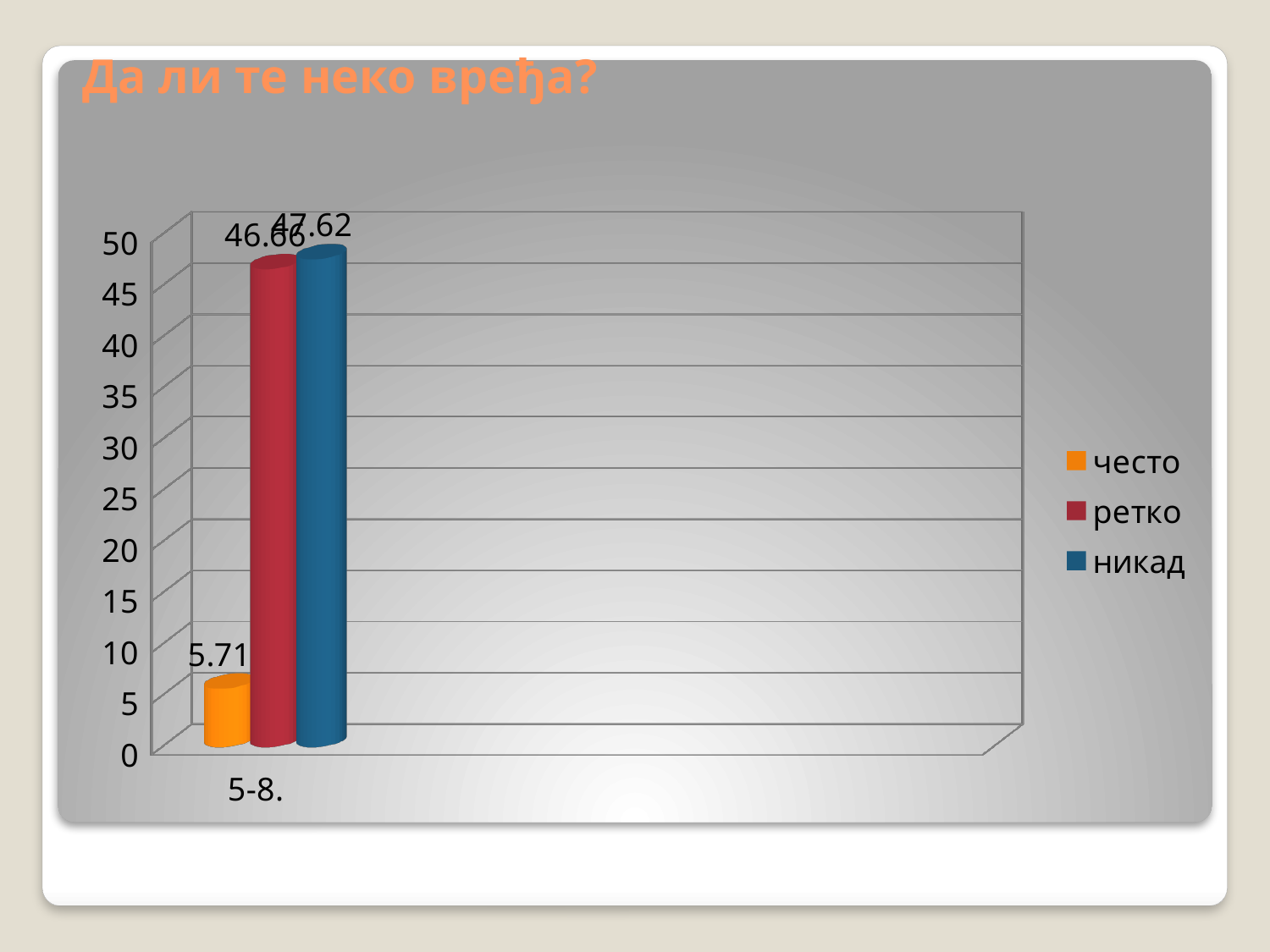
How many series does the legend list? 3 How many categories are shown on the x axis of the chart? 1 What kind of chart is shown on the slide? bar chart Which series has the lowest value in the chart? често Which series has the highest value in the chart? никад What is the difference between the values for "никад" and "често"? 41.91 Is the value for "често" greater or less than 10? less Is the value for "ретко" greater or less than 40? greater Which is larger, the value for "често" or the value for "никад"? никад What is the title of the slide? Да ли те неко вређа? What is the value for the series "често" in the chart? 5.71 What is the value for the series "никад" in the chart? 47.62